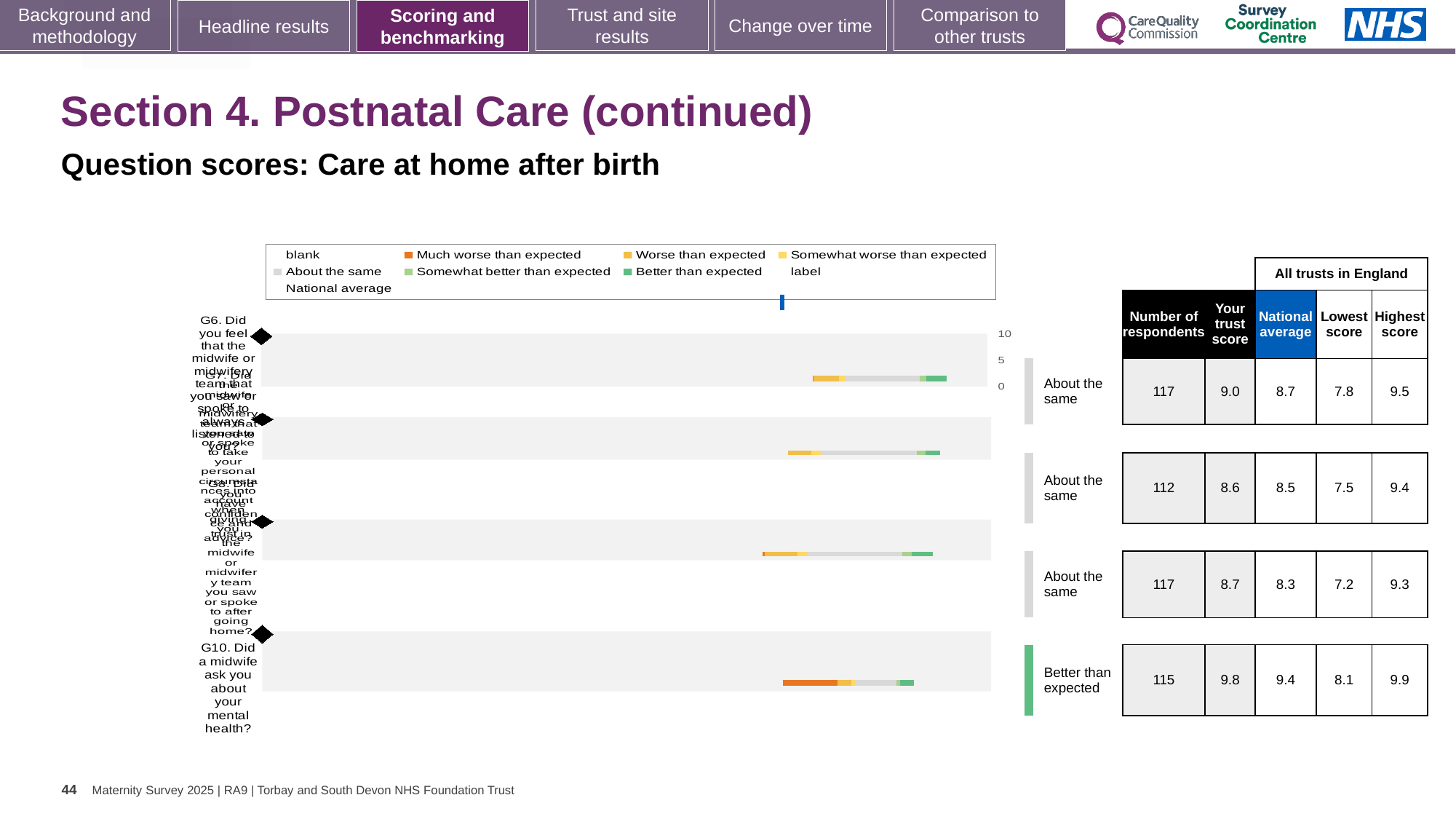
How is the trust's result for G10 (Did a midwife ask you about your mental health?) categorised? Better than expected What is the trust score for G10 (Did a midwife ask you about your mental health?)? 9.8 In the legend, what colour represents 'Better than expected'? green For G10, which is larger: the trust score or the national average? the trust score How many question rows are plotted in the chart? 4 What kind of chart is shown on the slide? bar chart What is the highest score across all trusts in England for G10 (Did a midwife ask you about your mental health?)? 9.9 What is the national average for G10 (Did a midwife ask you about your mental health?)? 9.4 For G10, what is the difference between the trust score and the national average? 0.4 Which question row has the highest trust score? G10 (Did a midwife ask you about your mental health?) How many respondents answered G10 (Did a midwife ask you about your mental health?)? 115 What is the lowest trust score shown among the four question rows? 8.6